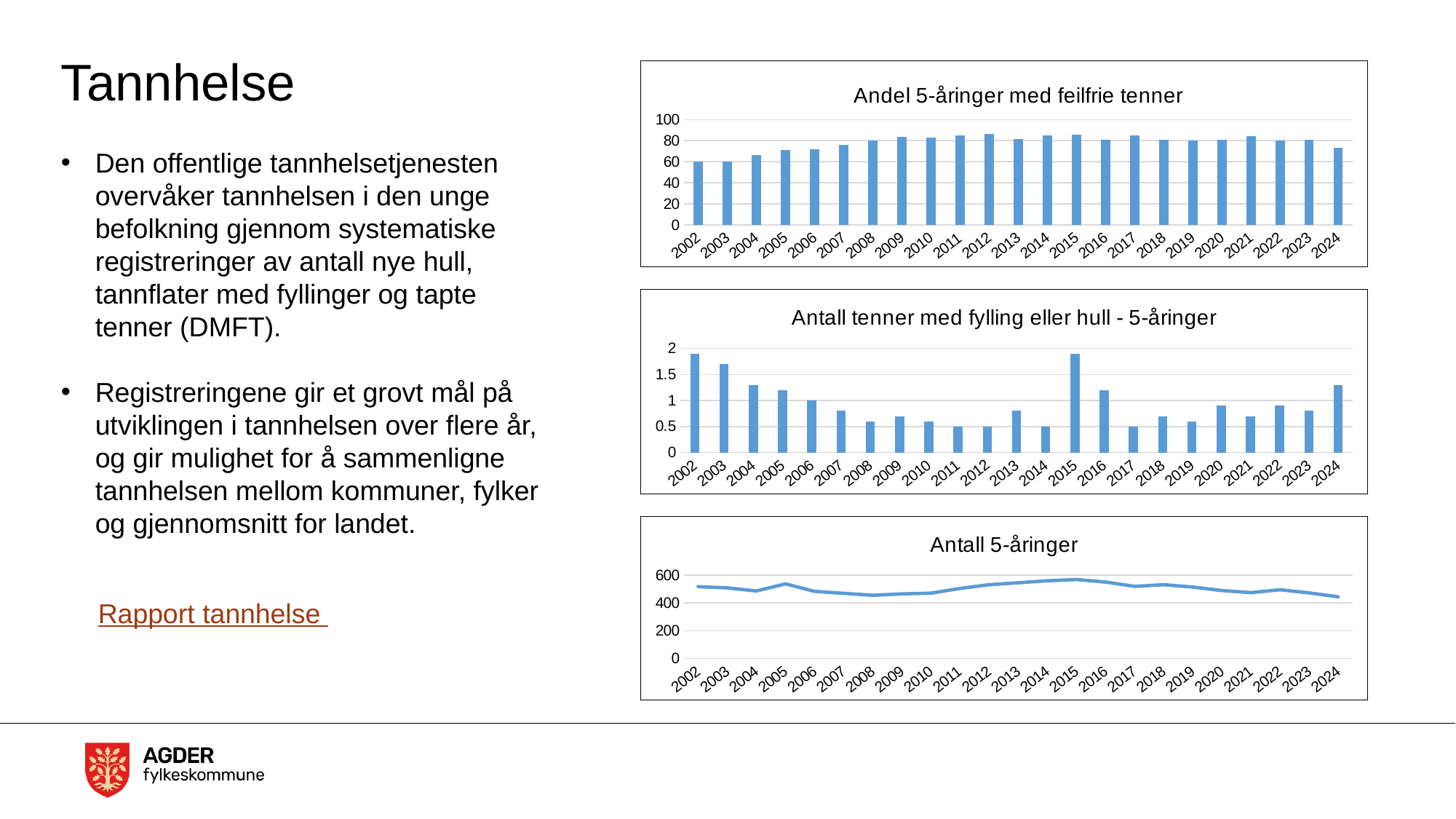
What kind of chart is the bottom chart, 'Antall 5-åringer'? line chart In the middle chart, 'Antall tenner med fylling eller hull - 5-åringer', which year has the larger value, 2002 or 2010? 2002 In the top chart, 'Andel 5-åringer med feilfrie tenner', do the values rise or fall from 2002 to 2012? rise In the bottom chart, 'Antall 5-åringer', do the values rise or fall from 2015 to 2024? fall What kind of chart is the top chart, 'Andel 5-åringer med feilfrie tenner'? bar chart In the top chart, 'Andel 5-åringer med feilfrie tenner', is the value for 2024 greater or less than 80? less In the bottom chart, 'Antall 5-åringer', is the value for 2015 greater or less than 400? greater How many years are shown on the x axis of the top chart, 'Andel 5-åringer med feilfrie tenner'? 23 In the middle chart, 'Antall tenner med fylling eller hull - 5-åringer', is the value for 2015 greater or less than 1.5? greater In the top chart, 'Andel 5-åringer med feilfrie tenner', which year has the larger value, 2002 or 2012? 2012